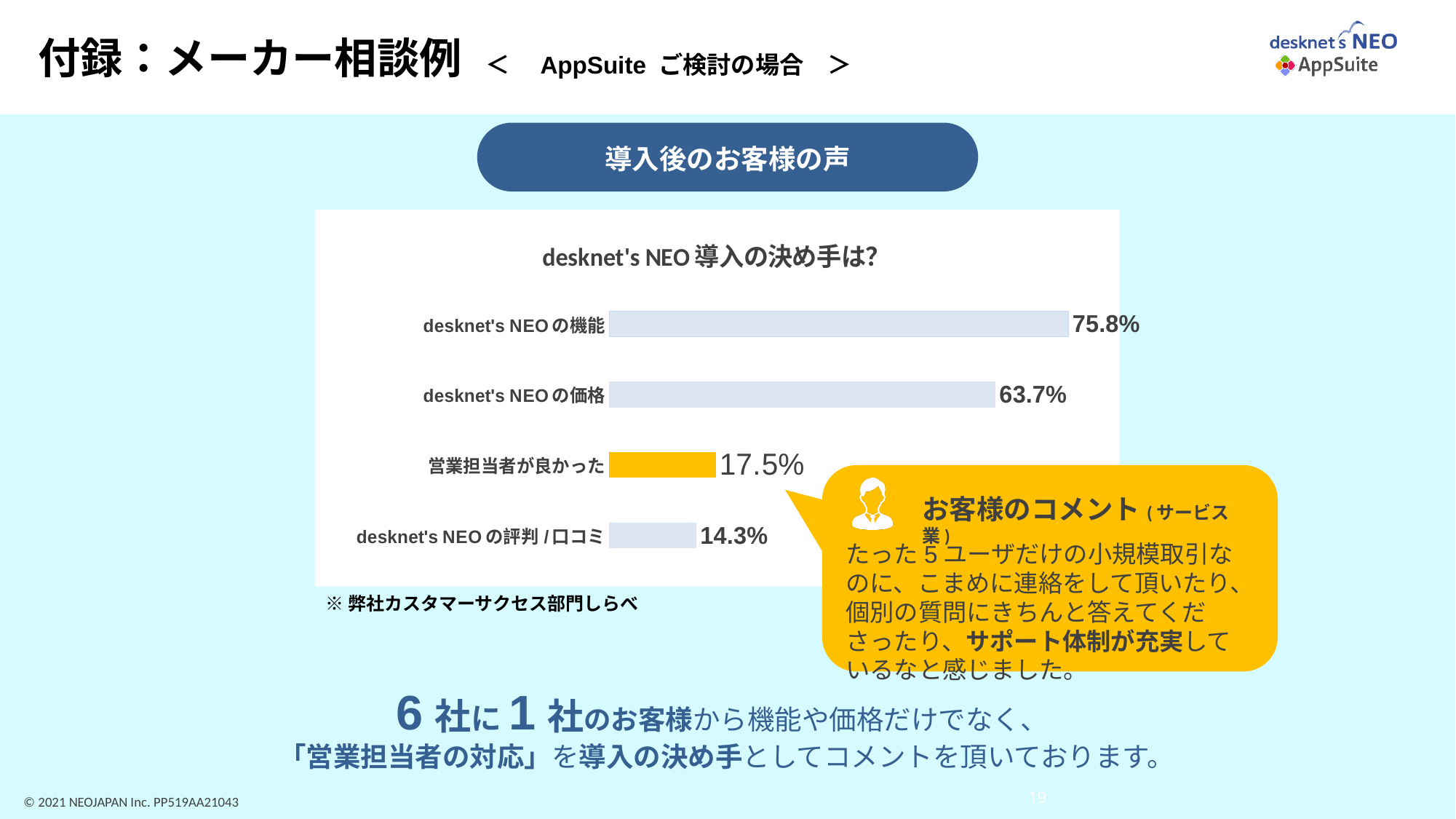
What is the title of the chart? desknet's NEO 導入の決め手は? What kind of chart is shown on the slide? Bar chart How many categories are shown in the chart? 4 What is the value for desknet's NEO の評判/口コミ in the chart? 14.3% What is the difference between the values for 営業担当者が良かった and desknet's NEO の評判/口コミ? 3.2% What is the value for desknet's NEO の価格 in the chart? 63.7% What is the difference between the values for desknet's NEO の機能 and desknet's NEO の価格? 12.1% Which category has the highest value in the chart? desknet's NEO の機能 Which category has the lowest value in the chart? desknet's NEO の評判/口コミ What is the value for desknet's NEO の機能 in the chart? 75.8% Which is larger, the value for desknet's NEO の価格 or the value for 営業担当者が良かった? desknet's NEO の価格 What is the value for 営業担当者が良かった in the chart? 17.5%